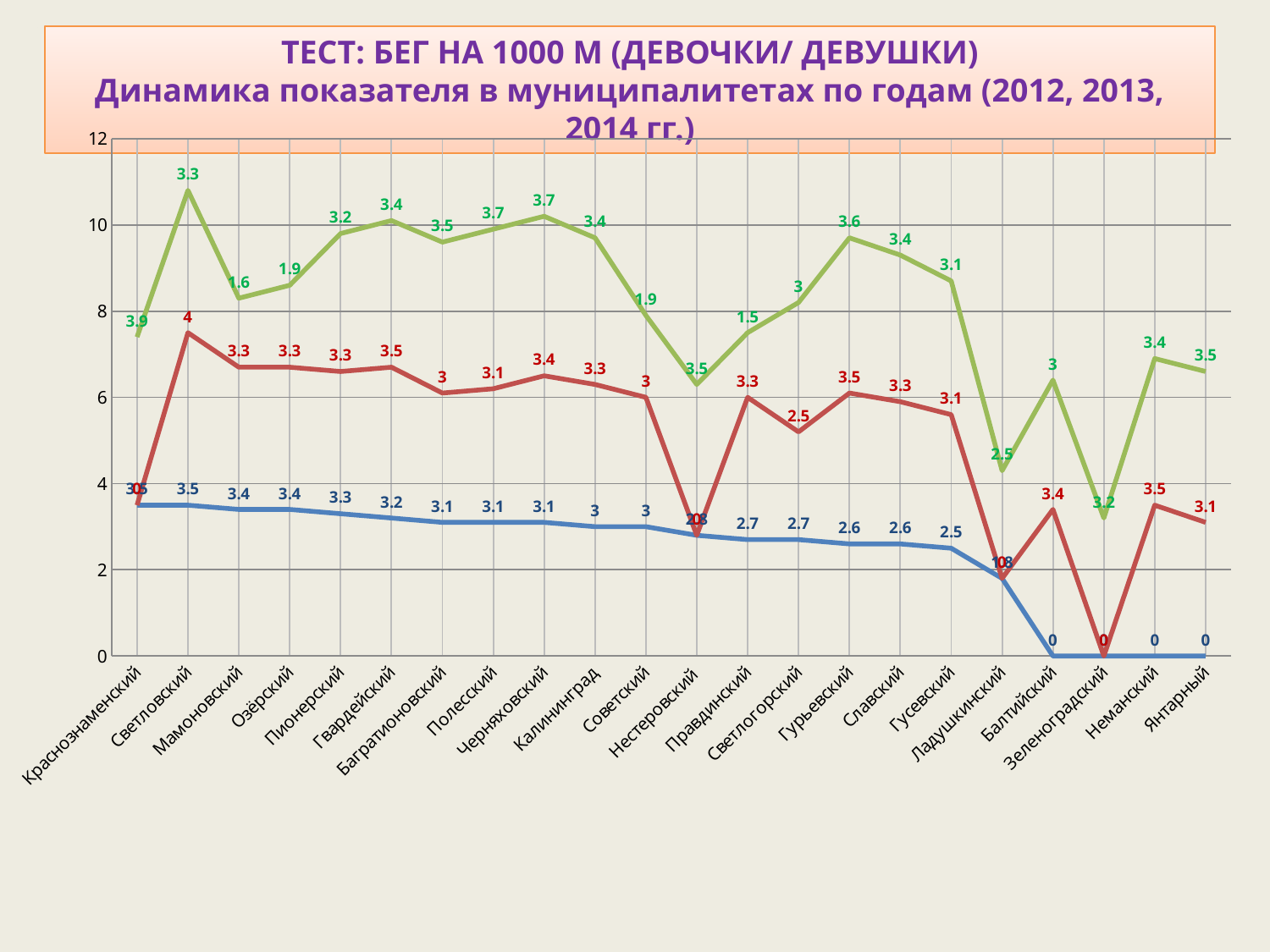
What is the value of the blue line for Гусевский? 2.5 Which coloured line lies highest on the chart for most municipalities? green What is the value of the blue line for Калининград? 3 What is the value of the blue line for Светловский? 3.5 What kind of chart is shown on the slide? line chart Does the blue line generally rise or fall from left to right across the municipalities? fall On the blue line, which is larger: the value for Краснознаменский or the value for Гусевский? Краснознаменский What is the difference between the blue line values for Светловский and Гусевский? 1 What is the value of the blue line for Балтийский? 0 How many municipalities are listed along the x axis of the chart? 22 What is the maximum value shown on the y axis of the chart? 12 How many lines are plotted on the chart? 3